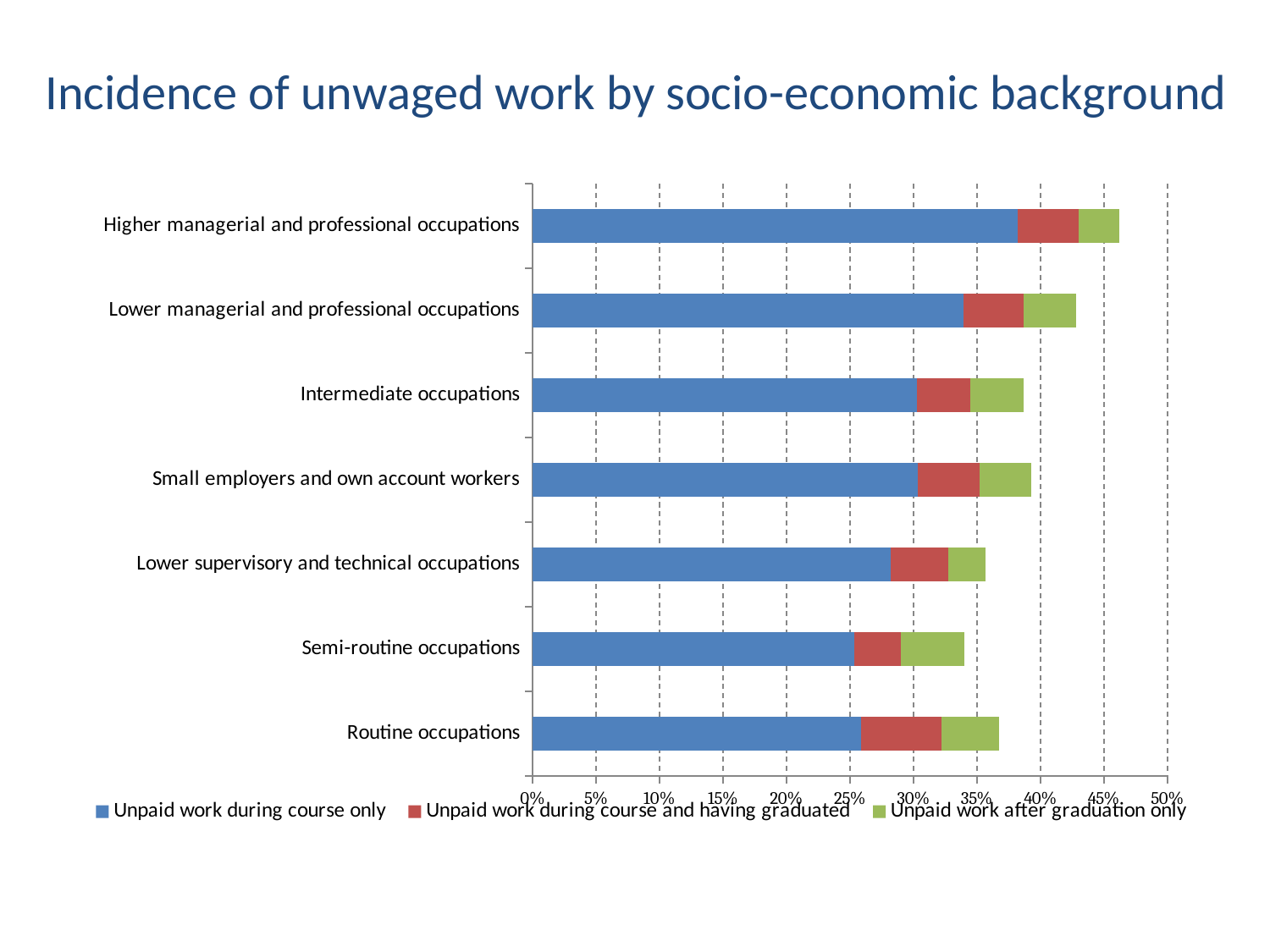
Is the total bar for Lower managerial and professional occupations greater or less than 40%? greater What is the title of the chart? Incidence of unwaged work by socio-economic background Which occupation category has the longest total bar? Higher managerial and professional occupations Is the total bar for Higher managerial and professional occupations greater or less than 45%? greater Is the total bar for Semi-routine occupations greater or less than 35%? less Which series is shown in green in the legend? Unpaid work after graduation only How many occupation categories are shown on the chart? 7 Which has the larger total bar: Higher managerial and professional occupations or Lower managerial and professional occupations? Higher managerial and professional occupations How many series does the legend list? 3 What kind of chart is shown on the slide? Stacked bar chart